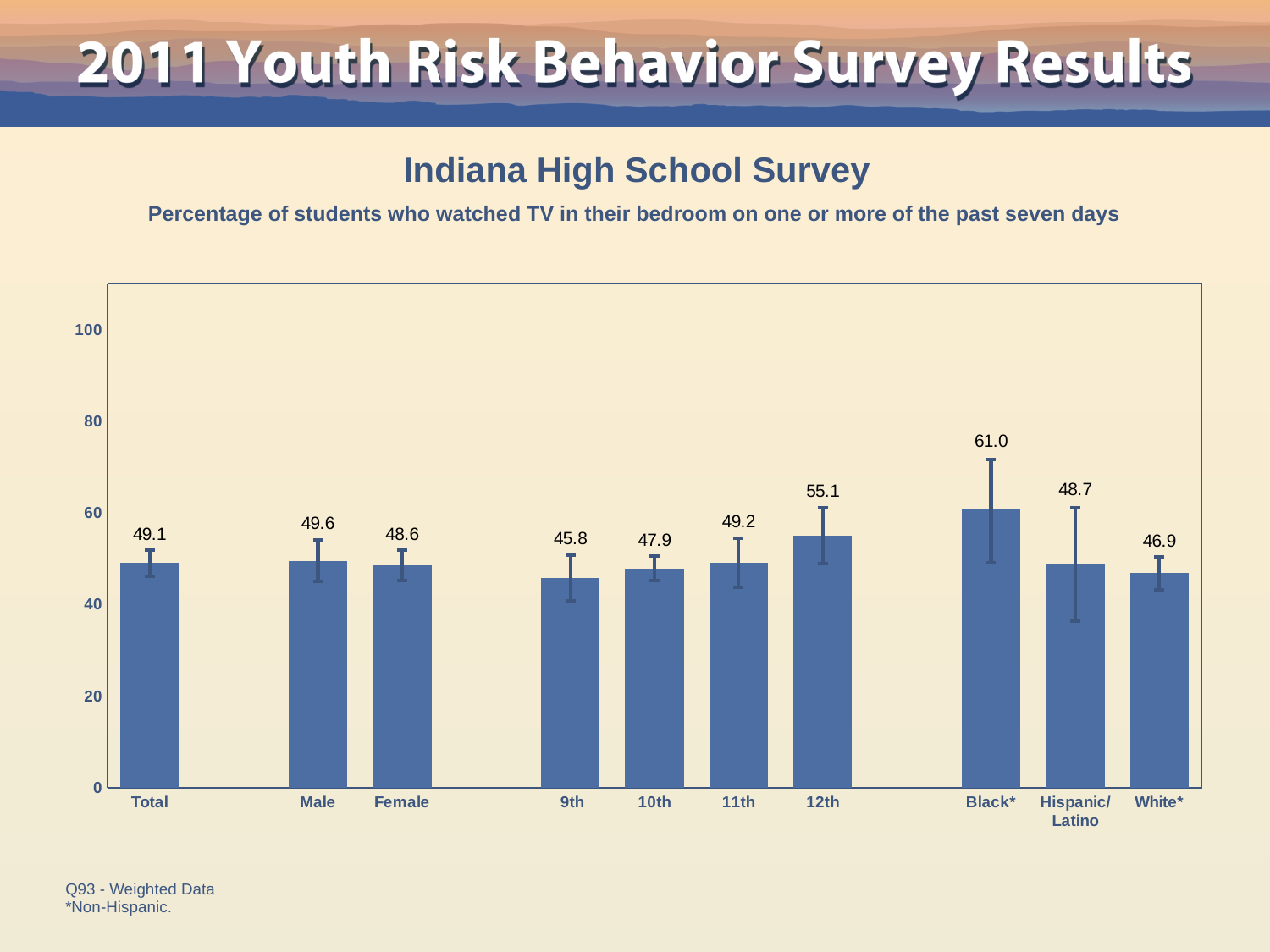
What is the value for Total? 49.1 Is the value for 12th grade greater or less than 60? less Which category has the highest value? Black* What is the value for Hispanic/Latino students? 48.7 What kind of chart is this? bar chart Do the values rise or fall from 9th grade to 12th grade? rise Which category has the lowest value? 9th What is the subtitle describing the measure plotted in the chart? Percentage of students who watched TV in their bedroom on one or more of the past seven days How many categories are shown on the x axis? 10 What is the difference between the values for Black* and White*? 14.1 What is the value for 12th grade? 55.1 Which is larger, the value for Male or the value for Female? Male